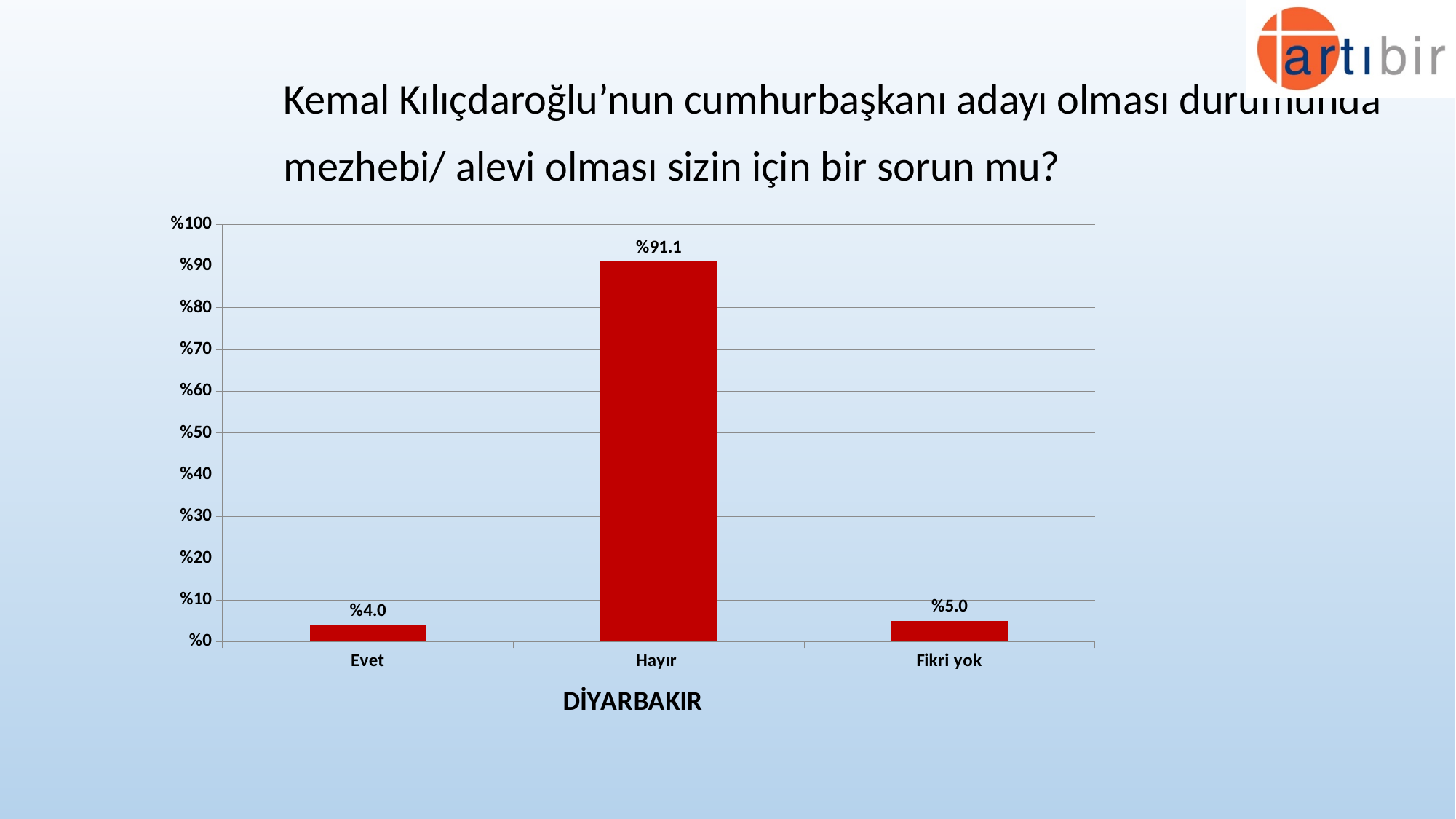
How many categories are shown on the x axis? 3 What is the value for Evet? %4.0 What is the value for Hayır? %91.1 Which is larger, the value for Evet or the value for Fikri yok? Fikri yok What kind of chart is shown on the slide? bar chart What is the value for Fikri yok? %5.0 Is the value for Hayır greater or less than %90? greater Which category has the highest value? Hayır Which category has the lowest value? Evet What is the difference between the values for Hayır and Fikri yok? %86.1 What is the difference between the values for Fikri yok and Evet? %1.0 What label appears below the x axis of the chart? DİYARBAKIR